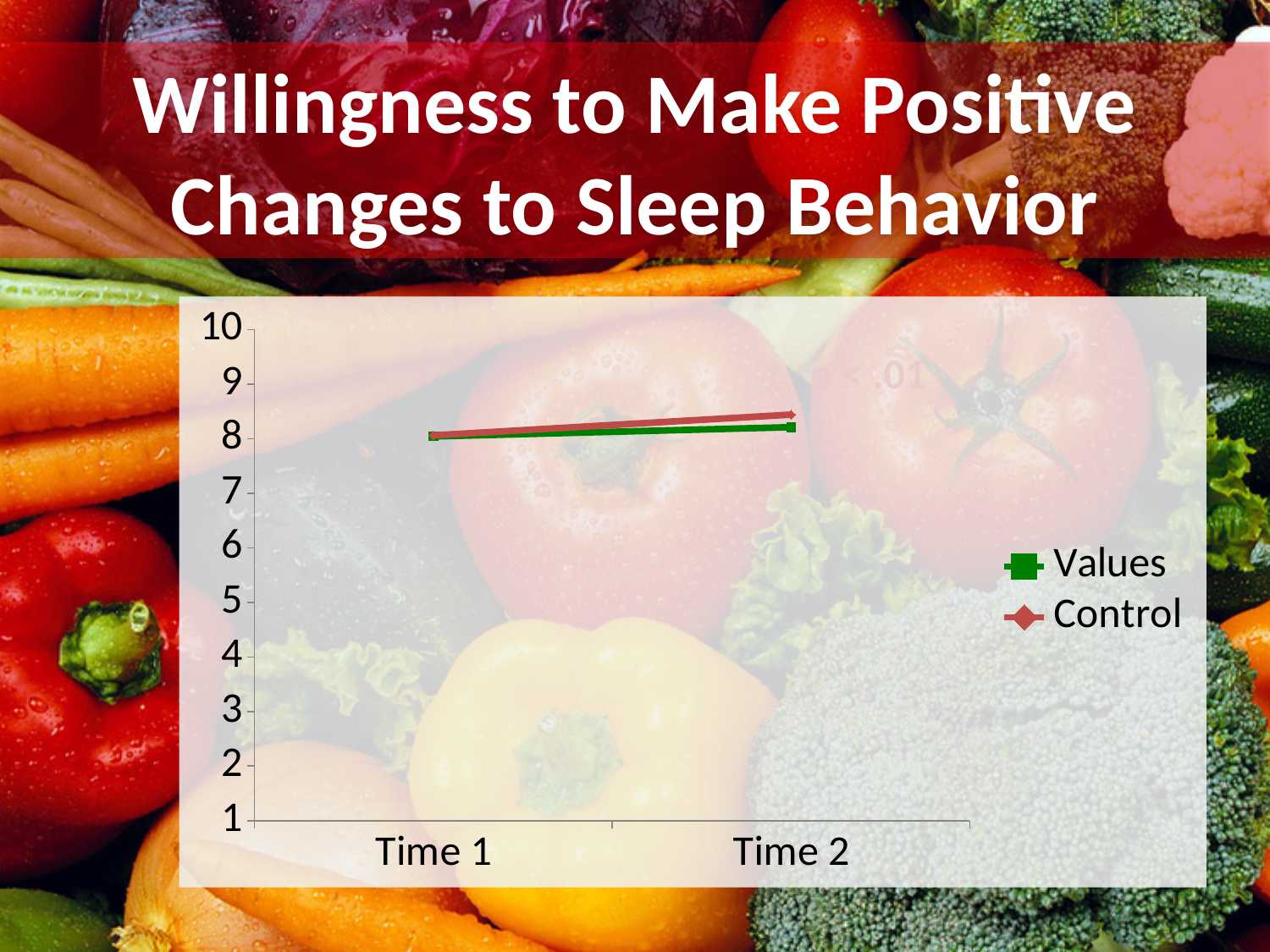
Is the value for the Values series at Time 2 greater or less than 7? greater What are the two categories on the x axis? Time 1 and Time 2 Is the value for the Control series at Time 2 greater or less than 9? less What is the highest value shown on the y axis? 10 What kind of chart is shown on the slide? line chart Does the Values series rise or fall from Time 1 to Time 2? rise How many series does the legend list? 2 How many time points are shown on the x axis? 2 Does the Control series rise or fall from Time 1 to Time 2? rise Which series is drawn in green? Values Is the value for the Values series at Time 1 greater or less than 7? greater